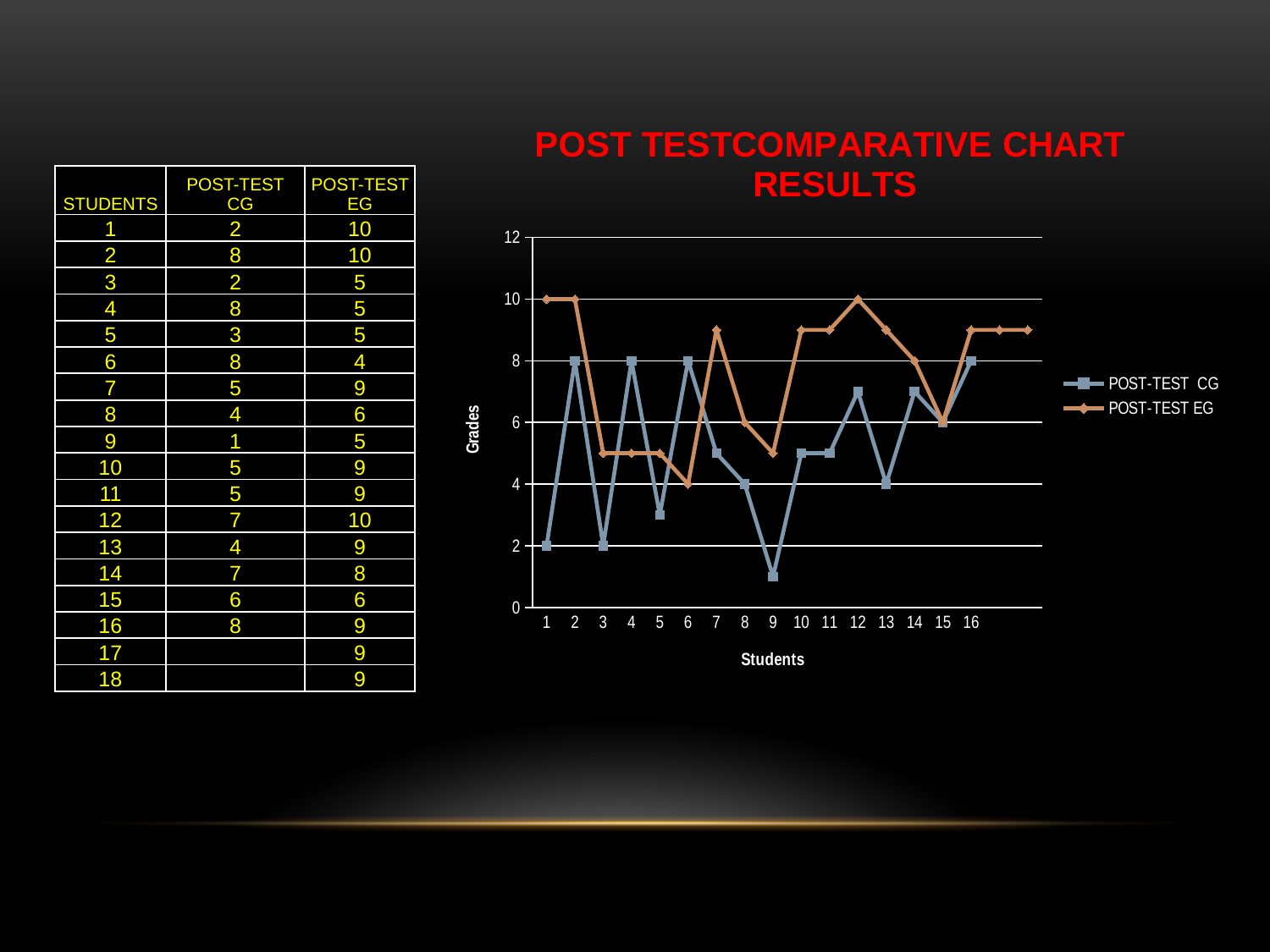
For student 6, which is larger: POST-TEST CG or POST-TEST EG? POST-TEST CG What is the difference between the POST-TEST EG and POST-TEST CG values for student 1? 8 Which student has the lowest POST-TEST CG value? 9 What is the title of the chart's vertical axis? Grades Does the POST-TEST EG line rise or fall from student 12 to student 15? fall What is the POST-TEST CG value for student 5? 3 Which student has the lowest POST-TEST EG value? 6 How many series does the chart legend list? 2 How many student labels are shown on the x axis of the chart? 16 What kind of chart is shown on the slide? line chart What is the POST-TEST EG value for student 12? 10 What is the POST-TEST CG value for student 9? 1